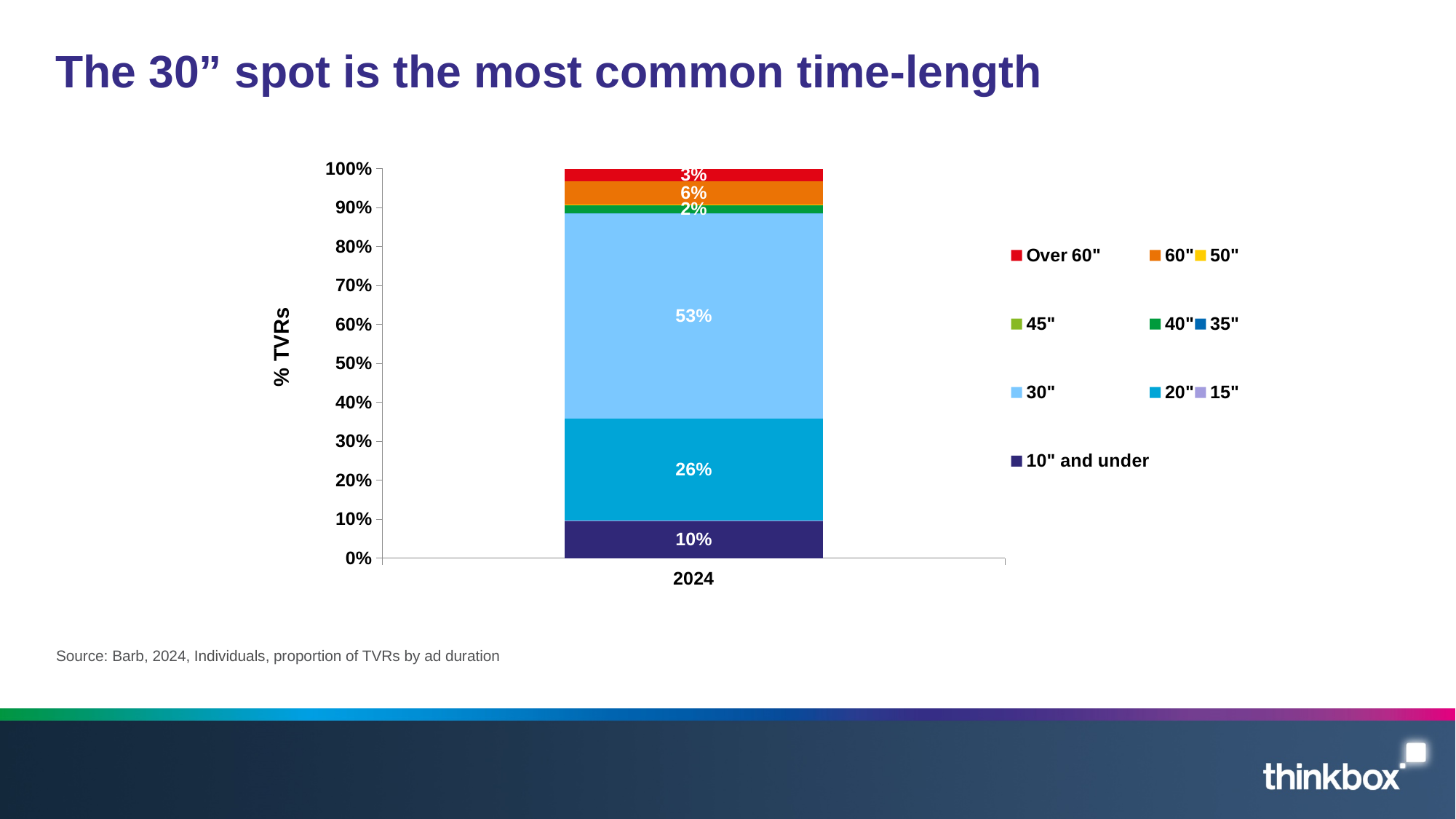
What type of chart is shown on the slide? Stacked bar chart What value is labelled on the 60" segment of the bar? 6% What is the title of the vertical axis? % TVRs How many percentage points larger is the 30" segment than the 20" segment? 27 percentage points Which ad duration has the largest share of TVRs in the 2024 bar? 30" Which segment is larger, 20" or 10" and under? 20" How many series does the legend list? 10 What percentage of TVRs is shown for the 30" segment in the 2024 bar? 53% What share of TVRs is shown for the 10" and under segment? 10% What value is labelled on the 20" segment of the 2024 bar? 26% How many categories are shown on the x axis? 1 What percentage is shown for the Over 60" segment? 3%